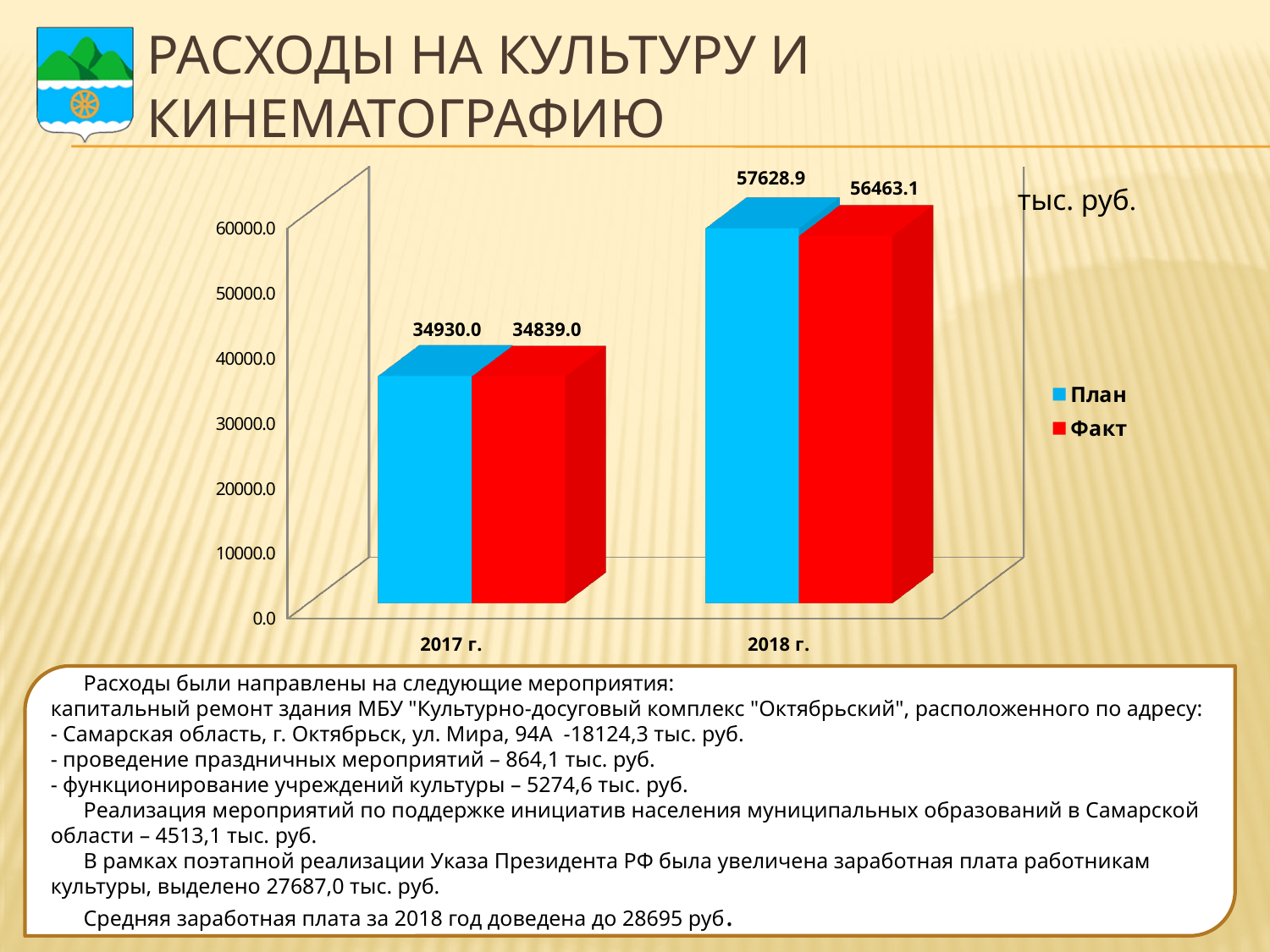
What is the Факт value for 2017 г.? 34839.0 Which year has the higher План value? 2018 г. What type of chart is shown on the slide? Bar chart By how much did the Факт value increase from 2017 г. to 2018 г.? 21624.1 How many series does the legend list? 2 For 2018 г., which is larger, План or Факт? План What is the План value for 2017 г.? 34930.0 Which bar shows the lowest value on the chart? Факт for 2017 г. How many years (categories) are shown on the x axis? 2 What is the difference between План and Факт for 2018 г.? 1165.8 What is the План value for 2018 г.? 57628.9 What is the Факт value for 2018 г.? 56463.1